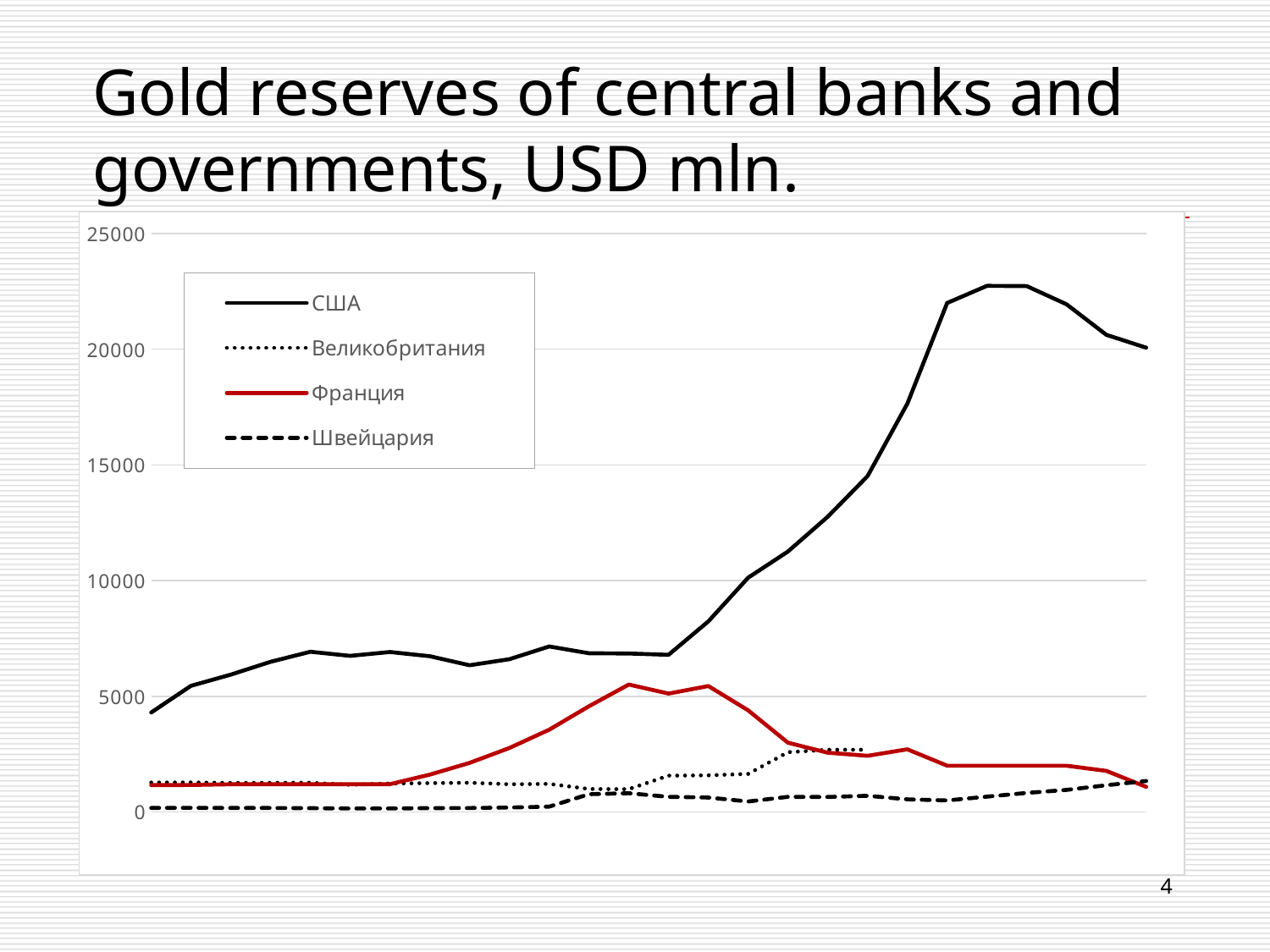
Which series reaches the highest value on the chart? США Does the США series overall rise or fall from the left end of the x axis to the right end? rise Is the peak value of the Франция series greater or less than 5000? greater What is the title of the slide containing the chart? Gold reserves of central banks and governments, USD mln. Is the highest value of the Великобритания series greater or less than 5000? less Is the peak value of the США series greater or less than 20000? greater What kind of chart is shown on the slide? line chart How many series does the legend list? 4 Which series is drawn in red? Франция Which series has the larger peak value, США or Франция? США